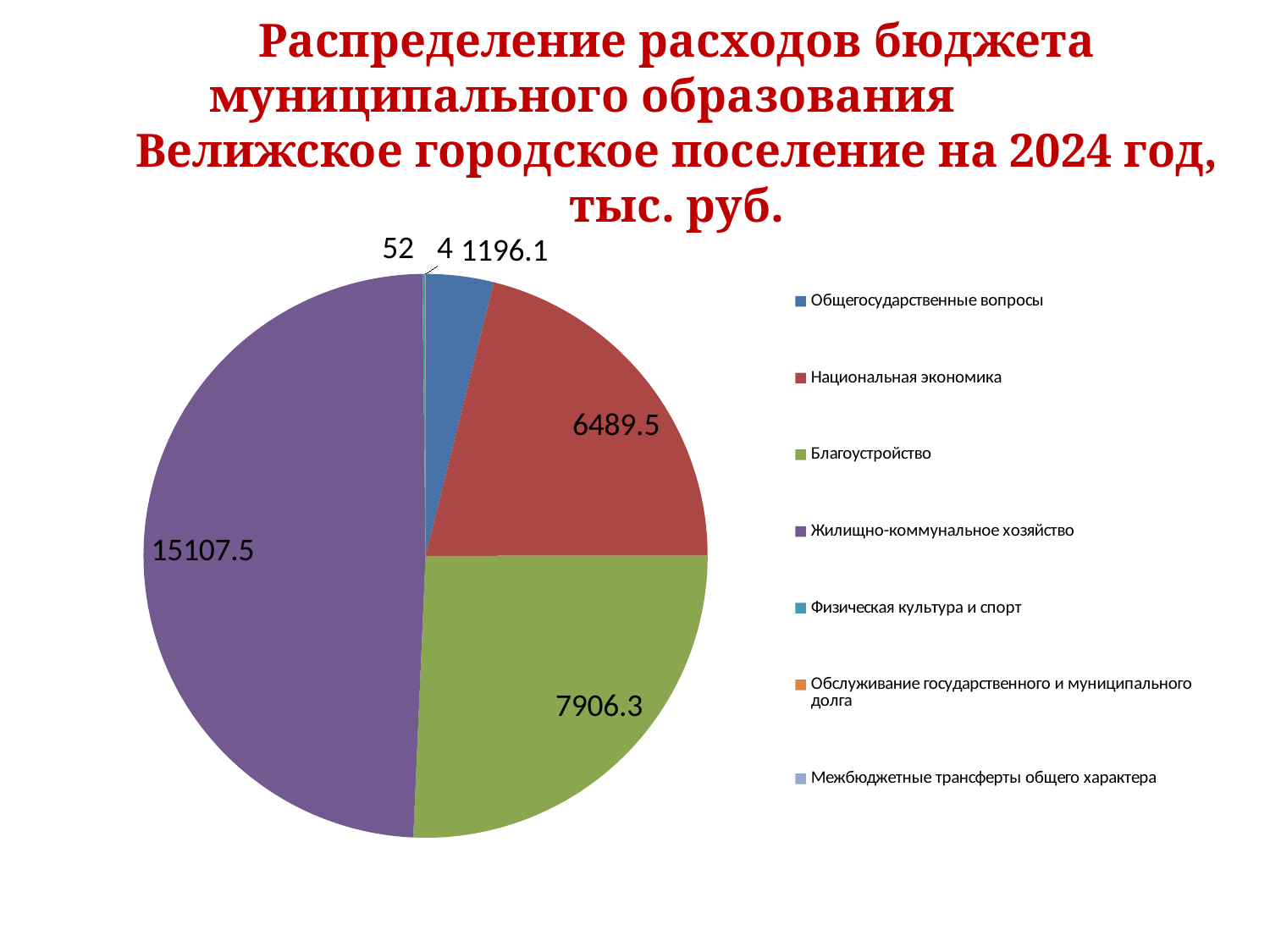
What is the difference between Жилищно-коммунальное хозяйство and Благоустройство? 7201.2 Which category has the largest slice of the pie? Жилищно-коммунальное хозяйство What is the value for Физическая культура и спорт? 52 What is the difference between Благоустройство and Национальная экономика? 1416.8 What is the value for Жилищно-коммунальное хозяйство? 15107.5 What is the value for Благоустройство? 7906.3 What is the value for Национальная экономика? 6489.5 What kind of chart is shown on the slide? pie chart What is the value for Общегосударственные вопросы? 1196.1 How many categories does the legend list? 7 In what units are the values in the chart expressed, according to the title? тыс. руб. Which is larger: Благоустройство or Национальная экономика? Благоустройство